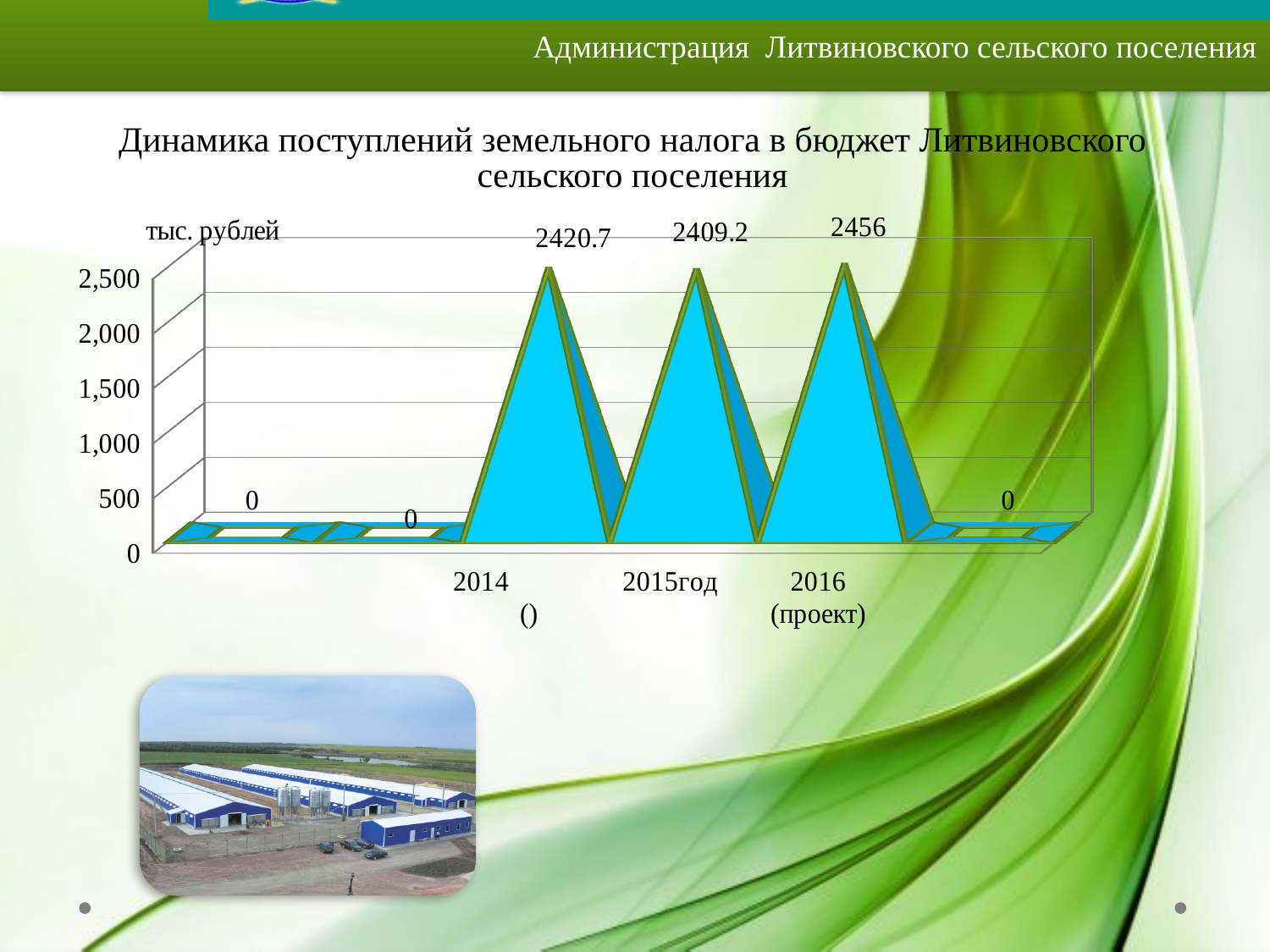
What kind of chart is shown on the slide? bar chart What is the value for 2014 on the chart? 2420.7 What is the difference between the values for 2014 and 2015год? 11.5 Which is larger, the value for 2014 or the value for 2015год? 2014 Does the value rise or fall from 2015год to 2016 (проект)? rise What is the value for 2016 (проект) on the chart? 2456 What is the value for 2015год on the chart? 2409.2 What is the difference between the values for 2016 (проект) and 2014? 35.3 Is the value for 2016 (проект) greater or less than 2,000? greater What unit is shown on the vertical axis of the chart? тыс. рублей Which labeled year has the highest value on the chart? 2016 (проект) Which labeled year has the lowest non-zero value on the chart? 2015год